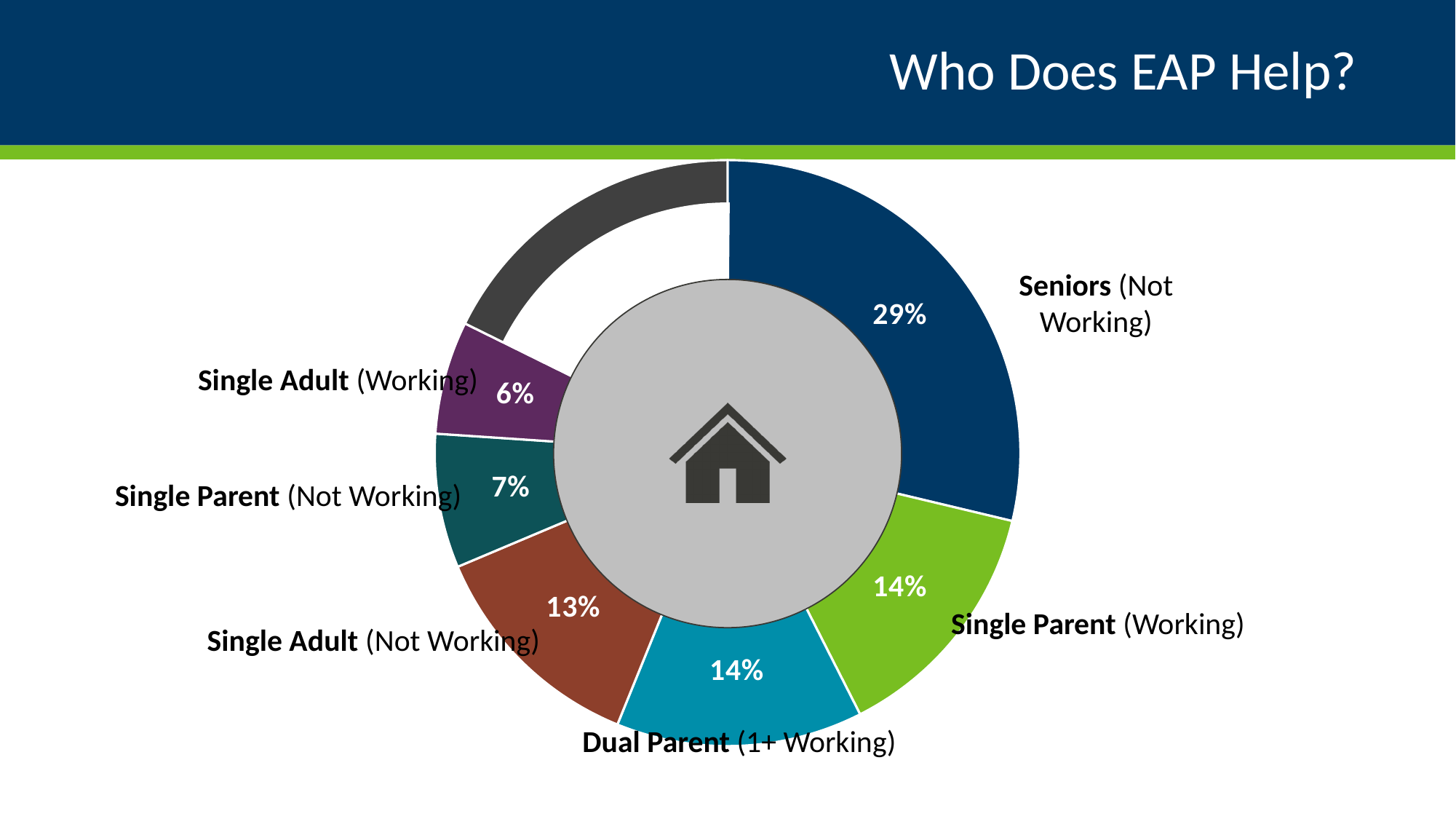
What is the value shown for Single Parent (Not Working)? 7% Which labeled category has the smallest share of the pie? Single Adult (Working) How many percentage points larger is Seniors (Not Working) than Single Parent (Working)? 15 What is the title of the slide? Who Does EAP Help? What percentage is labeled for Dual Parent (1+ Working)? 14% Which is larger: Single Adult (Not Working) or Single Parent (Not Working)? Single Adult (Not Working) What percentage of the pie chart is Seniors (Not Working)? 29% Which labeled category has the largest share of the pie? Seniors (Not Working) How many labeled categories are shown on the pie chart? 6 What kind of chart is shown on the slide? Doughnut chart What is the value for Single Adult (Not Working)? 13% What percentage does the Single Adult (Working) slice show? 6%